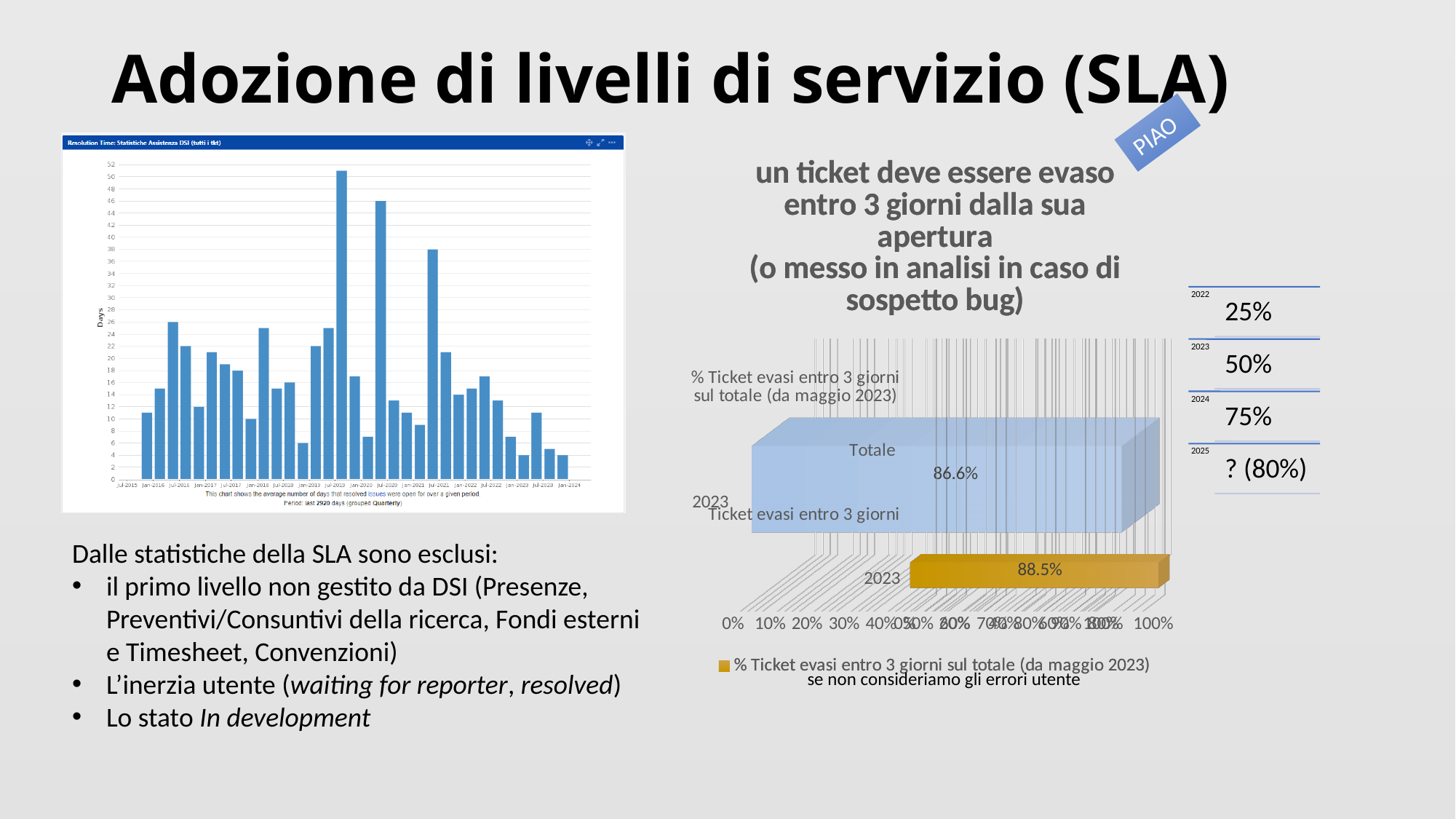
On the left chart (Resolution Time: Statistiche Assistenza DSI), what kind of chart is shown? bar chart On the gold 3D bar chart on the right, what series name does the legend show? % Ticket evasi entro 3 giorni sul totale (da maggio 2023) On the left chart (Resolution Time: Statistiche Assistenza DSI), what is the label of the vertical axis? Days On the gold 3D bar chart on the right, what is the value shown for 2023? 88.5% On the left chart (Resolution Time: Statistiche Assistenza DSI), is the value for Jul-2021 greater or less than 40? less On the blue 3D bar chart on the right, what is the value shown for Totale in 2023? 86.6% Which is larger, the 86.6% value on the blue 3D bar chart or the 88.5% value on the gold 3D bar chart? 88.5% On the left chart (Resolution Time: Statistiche Assistenza DSI), which is larger, the bar for Jul-2019 or the bar for Jul-2020? Jul-2019 What is the difference between the 88.5% value on the gold 3D bar chart and the 86.6% value on the blue 3D bar chart? 1.9% On the left chart (Resolution Time: Statistiche Assistenza DSI), is the value for Jul-2019 greater or less than 40? greater On the left chart (Resolution Time: Statistiche Assistenza DSI), is the value for Jan-2024 greater or less than 10? less On the left chart (Resolution Time: Statistiche Assistenza DSI), which period has the tallest bar? Jul-2019